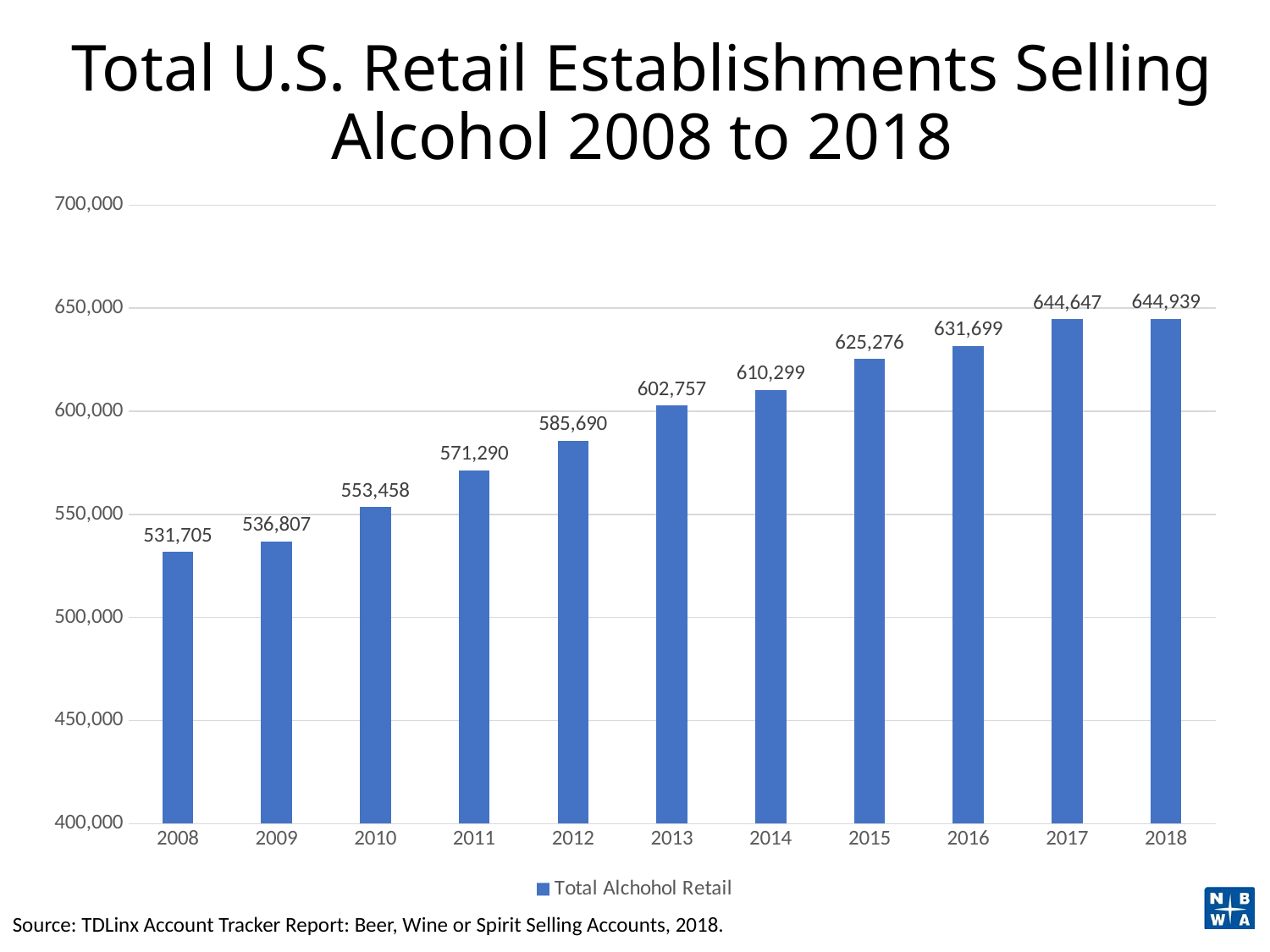
What is the difference between the values for 2018 and 2008? 113,234 Which year has the lowest value? 2008 Is the value for 2012 greater or less than 600,000? less Which is larger, the value for 2011 or the value for 2015? 2015 Do the values rise or fall from 2008 to 2018? rise What is the value for 2014? 610,299 Which year has the highest value? 2018 What kind of chart is this? bar chart What is the value for 2008? 531,705 How many years are shown on the x axis? 11 What is the difference between the values for 2013 and 2012? 17,067 What is the value for 2018? 644,939